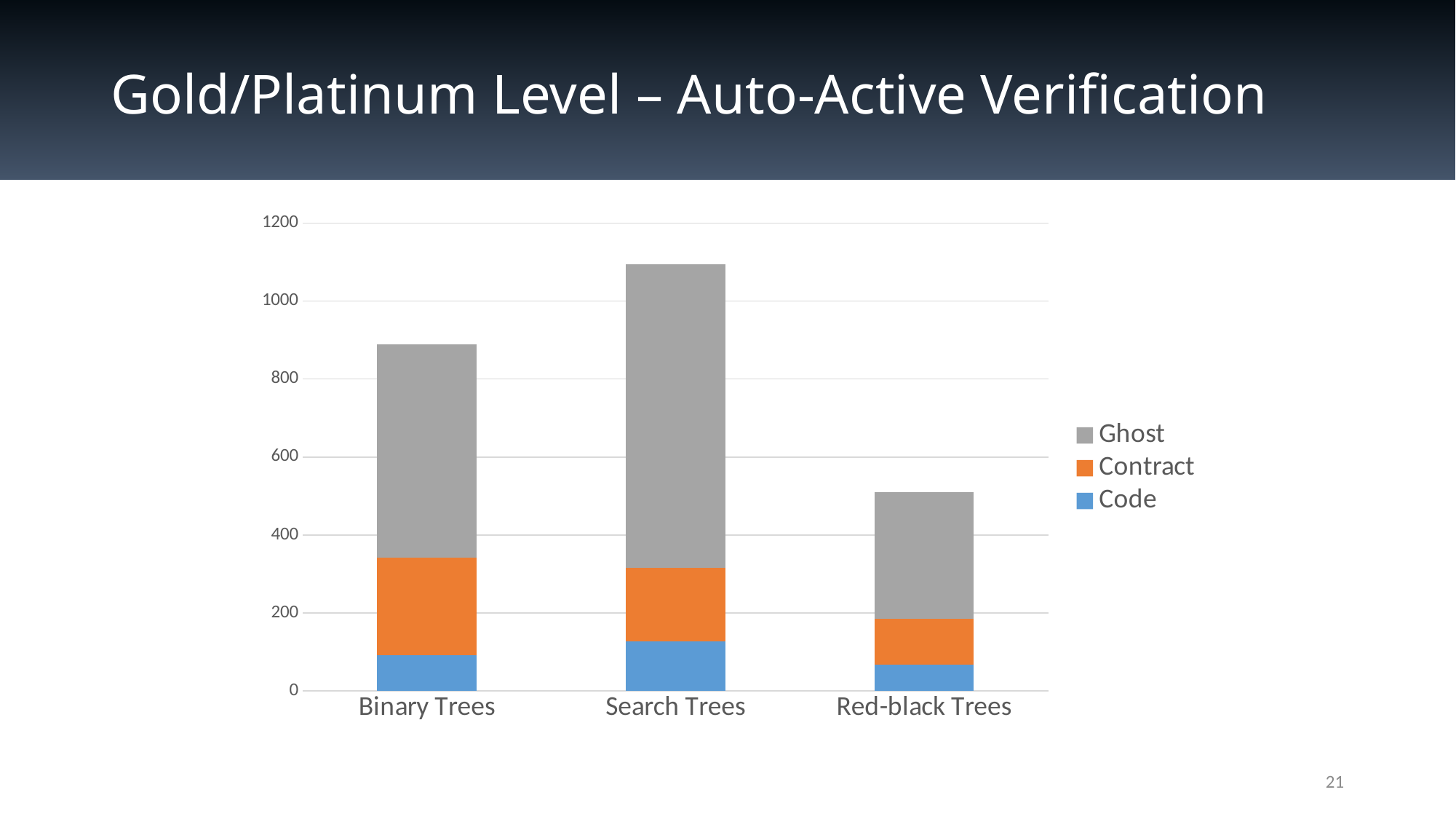
Which category has the tallest stacked bar overall? Search Trees Which series is shown in grey in the chart? Ghost Is the total stacked bar for Binary Trees greater or less than 1000? less Which series is shown in blue at the bottom of each stacked bar? Code What kind of chart is shown on the slide? stacked bar chart Is the total stacked bar for Search Trees greater or less than 1000? greater Which category has the shortest stacked bar overall? Red-black Trees How many series does the chart's legend list? 3 Is the Code value for Search Trees greater or less than 200? less Which category has a larger total stacked bar, Binary Trees or Red-black Trees? Binary Trees How many categories are shown on the x axis of the chart? 3